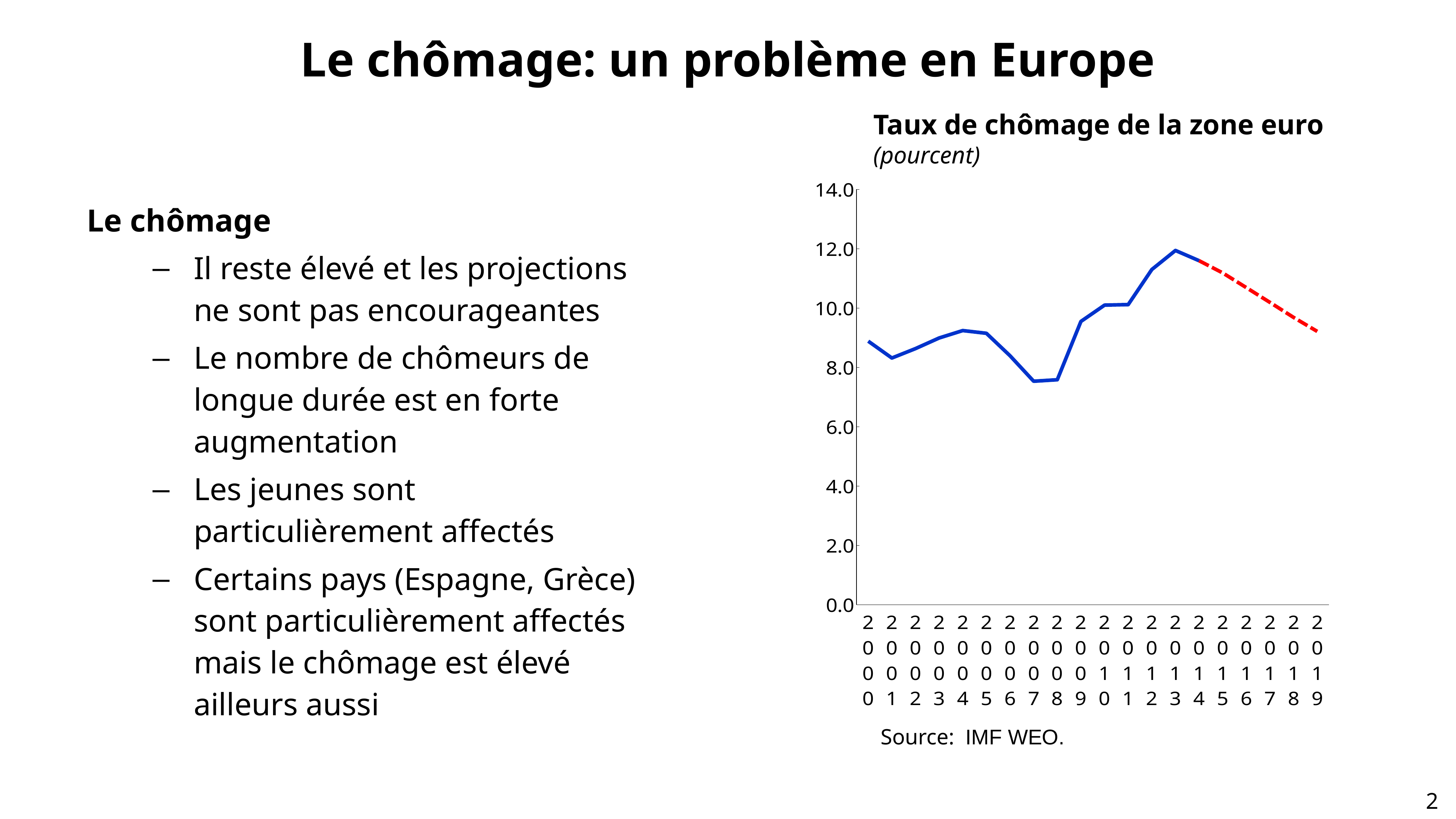
What is the title of the chart? Taux de chômage de la zone euro How many years are shown on the x axis of the chart? 20 What kind of chart is shown on the slide? line chart Is the value for 2012 greater or less than 10.0? greater Is the value for 2007 greater or less than 8.0? less What is the source cited below the chart? IMF WEO. Which year has the higher unemployment rate, 2009 or 2008? 2009 Which year has the higher unemployment rate, 2013 or 2007? 2013 Does the unemployment rate rise or fall between 2009 and 2013? rise Is the projected value for 2019 greater or less than 10.0? less In which year does the unemployment rate reach its highest point on the chart? 2013